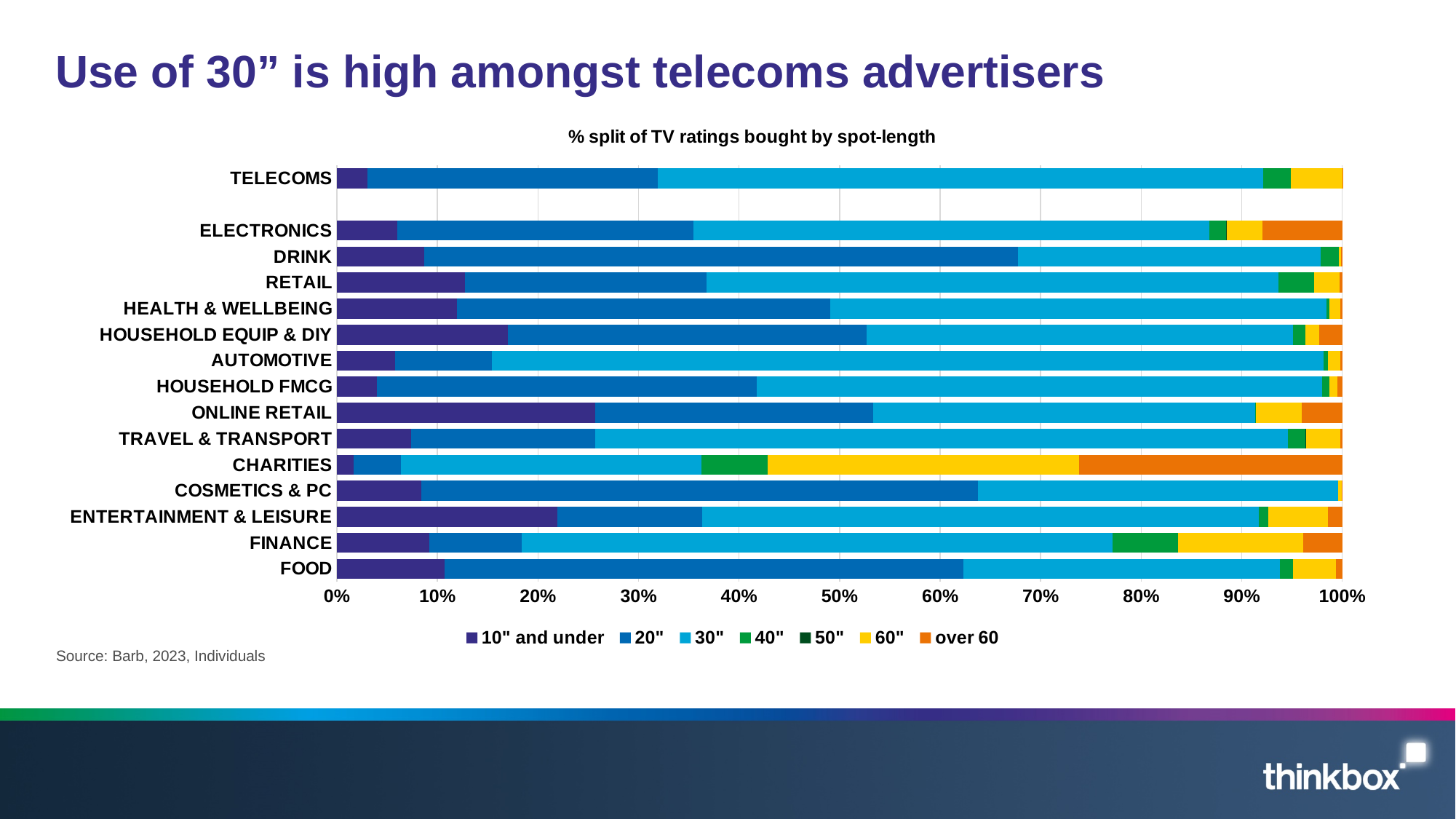
Which category has the largest '60"' segment? CHARITIES Is the '20"' value for DRINK greater or less than 50%? greater What source is cited for the chart data? Barb, 2023, Individuals Is the '10" and under' value for TELECOMS greater or less than 10%? less How many categories (advertiser sectors) are plotted on the chart? 15 What kind of chart is shown on the slide? Stacked bar chart Which category has the largest '30"' segment? AUTOMOTIVE Is the '10" and under' value for ONLINE RETAIL greater or less than 20%? greater Which has the larger 'over 60' segment, CHARITIES or FINANCE? CHARITIES How many series does the legend list? 7 What is the title of the chart? % split of TV ratings bought by spot-length Which category has the largest 'over 60' segment? CHARITIES